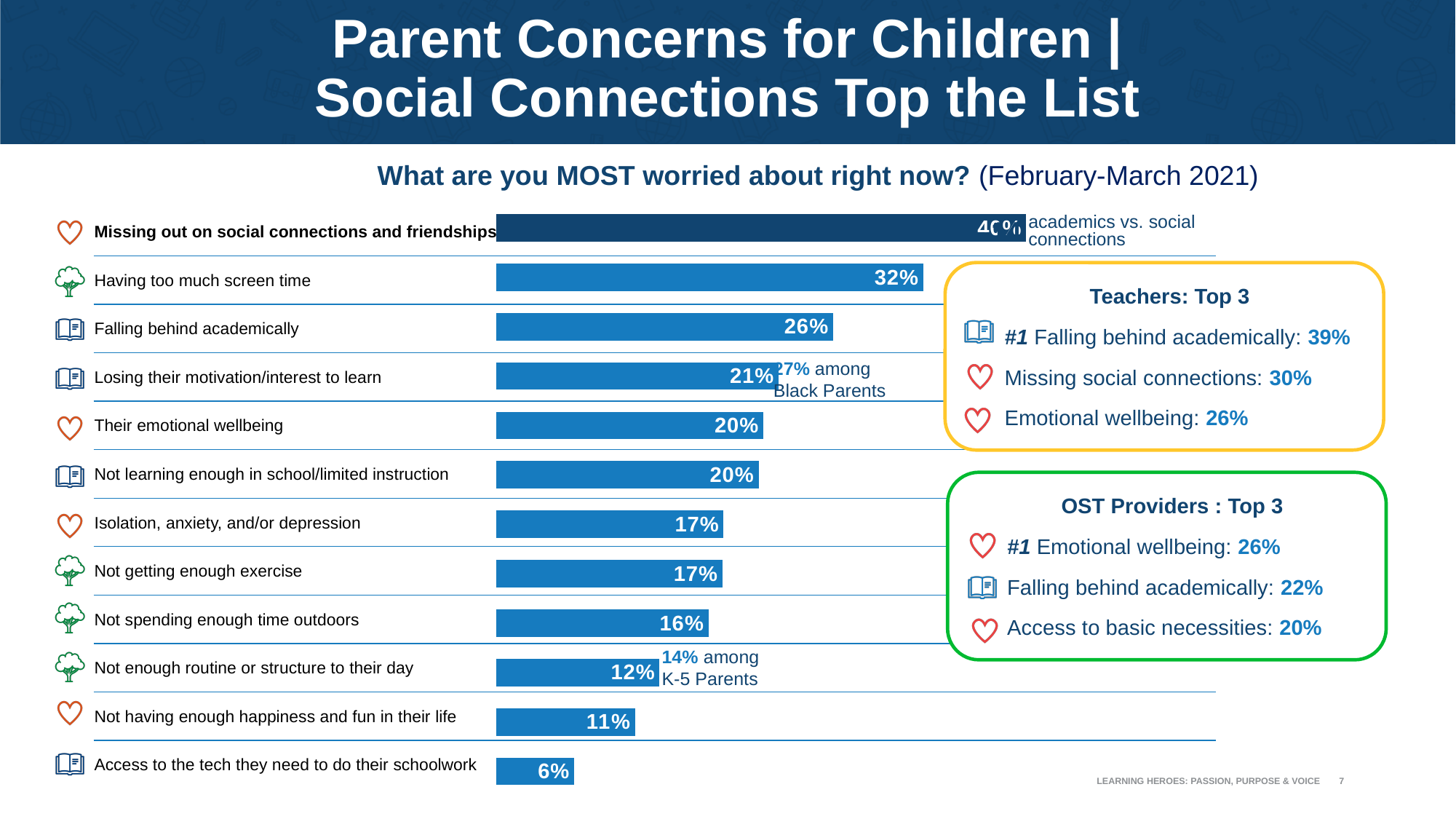
Which concern has the longest bar in the chart? Missing out on social connections and friendships What is the difference between the values for 'Their emotional wellbeing' and 'Access to the tech they need to do their schoolwork'? 14% What is the difference between the values for 'Having too much screen time' and 'Falling behind academically'? 6% What is the value for 'Not spending enough time outdoors'? 16% What percentage of parents said they are most worried about their child having too much screen time? 32% Which concern has the lowest value in the chart? Access to the tech they need to do their schoolwork How many concern categories are plotted in the bar chart? 12 Which is larger: the value for 'Losing their motivation/interest to learn' or the value for 'Not enough routine or structure to their day'? Losing their motivation/interest to learn What is the value for 'Not having enough happiness and fun in their life'? 11% What is the value for 'Falling behind academically'? 26% According to the 'Teachers: Top 3' box, what percentage of teachers cited 'Falling behind academically'? 39% What kind of chart is shown on the slide? Bar chart